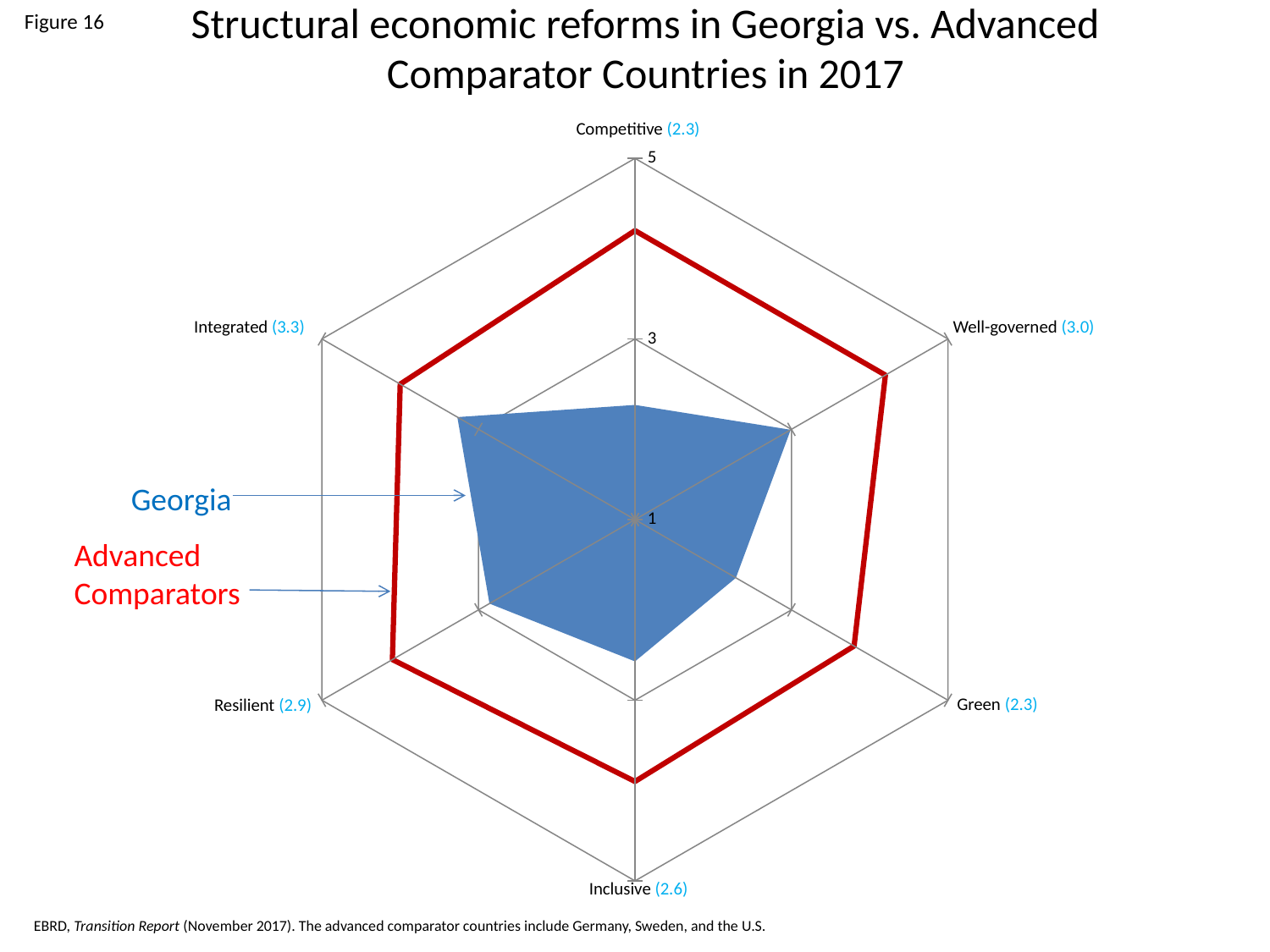
What is the difference between Georgia's Well-governed score and its Inclusive score? 0.4 What is Georgia's score on the Well-governed dimension? 3.0 Which is higher for Georgia: the Resilient score or the Inclusive score? Resilient On the Inclusive dimension, which series has the higher value: Georgia or Advanced Comparators? Advanced Comparators What is Georgia's score on the Inclusive dimension? 2.6 On which dimension does Georgia have its highest score? Integrated What kind of chart is shown on the slide? Radar chart What is Georgia's score on the Integrated dimension? 3.3 How many dimensions (axes) does the radar chart show? 6 How many series are plotted on the chart? 2 What is the difference between Georgia's Integrated score and its Competitive score? 1.0 Is the Advanced Comparators value for Competitive greater or less than 3? greater